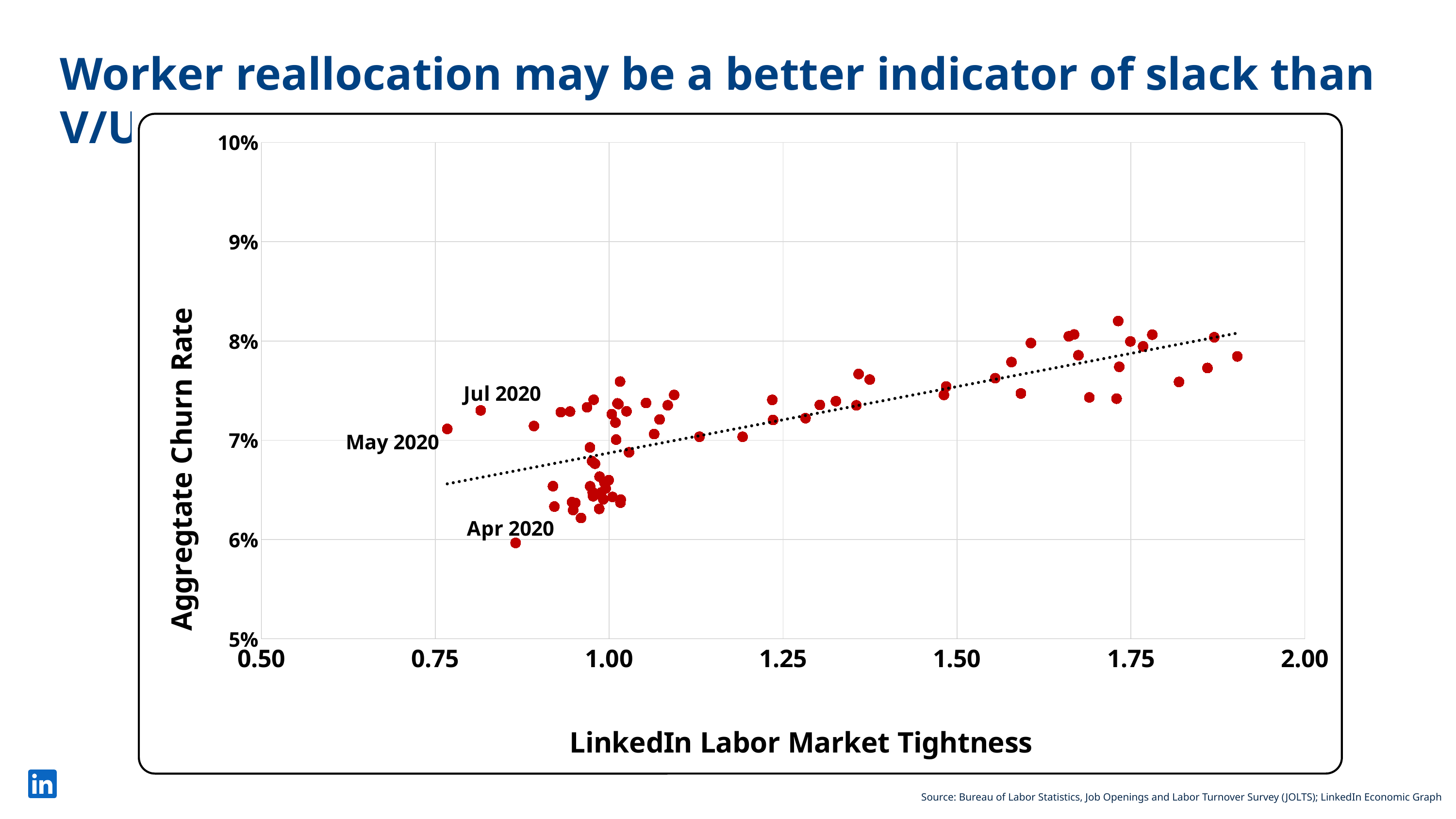
Is the LinkedIn Labor Market Tightness for the point labeled May 2020 greater or less than 1.00? less Is the Aggregate Churn Rate for the point labeled May 2020 greater or less than 8%? less Is the LinkedIn Labor Market Tightness for the point labeled Apr 2020 greater or less than 1.00? less Which labeled point has a higher Aggregate Churn Rate, Apr 2020 or May 2020? May 2020 Which labeled point has a higher Aggregate Churn Rate, Apr 2020 or Jul 2020? Jul 2020 What is the title of the x axis of the chart? LinkedIn Labor Market Tightness Which of the three labeled points has the lowest Aggregate Churn Rate? Apr 2020 What kind of chart is shown on the slide? scatter plot As LinkedIn Labor Market Tightness increases along the x axis, does the Aggregate Churn Rate generally rise or fall? rise What is the highest value shown on the y axis of the chart? 10%